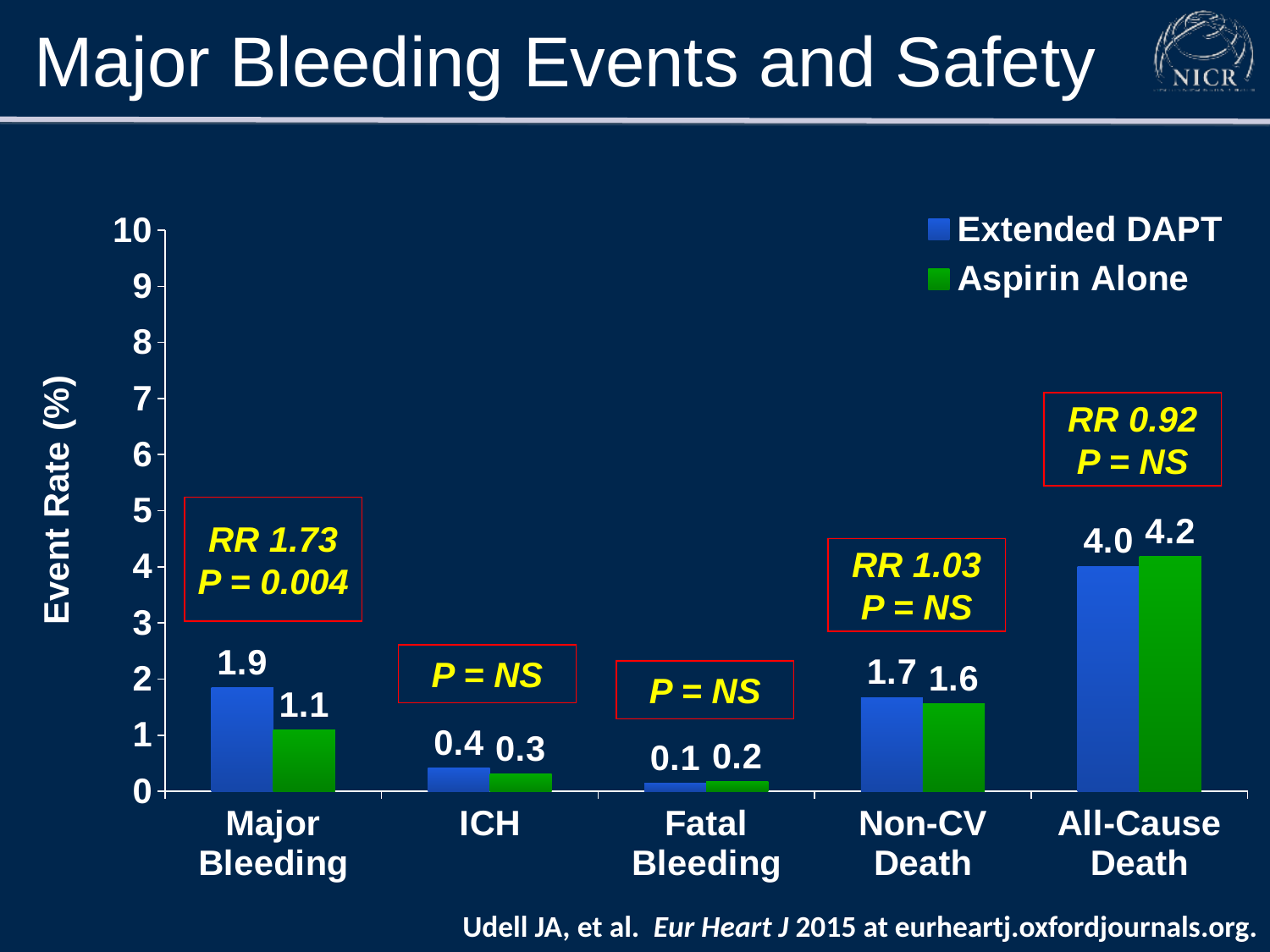
What kind of chart is shown on the slide? Bar chart Which category has the highest event rate for Extended DAPT? All-Cause Death What is the event rate for Aspirin Alone in the All-Cause Death category? 4.2 How many categories are shown on the x axis? 5 Which is larger for Non-CV Death: the Extended DAPT rate or the Aspirin Alone rate? Extended DAPT What is the difference between the Extended DAPT and Aspirin Alone event rates for Major Bleeding? 0.8 What is the label of the y axis? Event Rate (%) Is the Aspirin Alone event rate for All-Cause Death greater or less than 4? greater How many series does the legend list? 2 What is the event rate for Extended DAPT in the Major Bleeding category? 1.9 What is the event rate for Aspirin Alone in the Fatal Bleeding category? 0.2 Which category has the lowest event rate for Extended DAPT? Fatal Bleeding